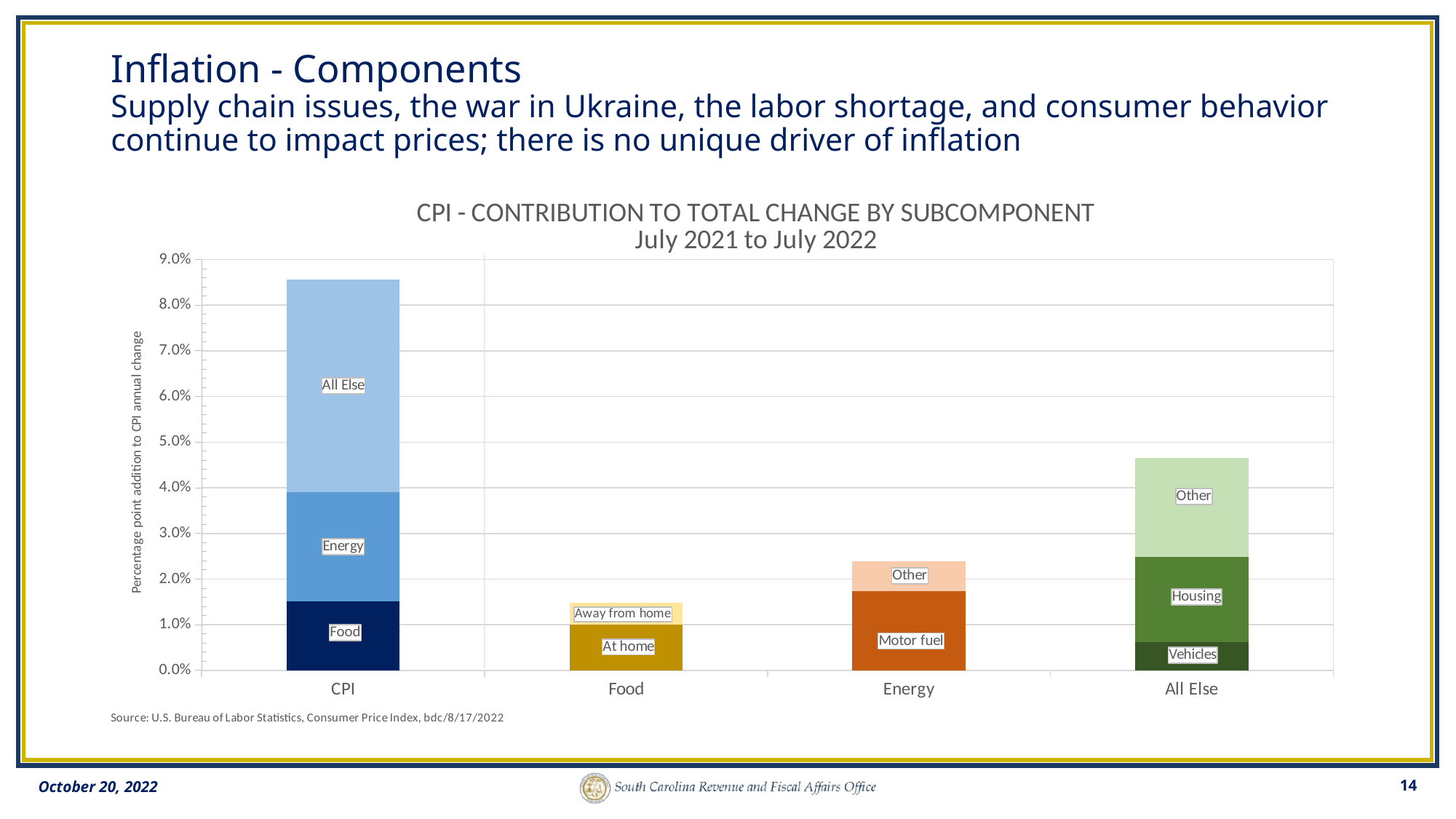
How many categories are shown on the x axis of the chart? 4 Is the total for the Food bar greater or less than 2.0%? less Within the Energy bar, which segment is larger, Motor fuel or Other? Motor fuel What kind of chart is shown on the slide? Stacked bar chart Which category has the tallest stacked bar? CPI Is the total for the All Else bar greater or less than 4.0%? greater What is the title of the chart? CPI - CONTRIBUTION TO TOTAL CHANGE BY SUBCOMPONENT July 2021 to July 2022 Which stacked bar is taller, Energy or All Else? All Else Within the All Else bar, which segment is larger, Housing or Vehicles? Housing Is the total for the CPI bar greater or less than 8.0%? greater What are the three segments labeled in the CPI bar, from bottom to top? Food, Energy, All Else Which category has the shortest stacked bar? Food